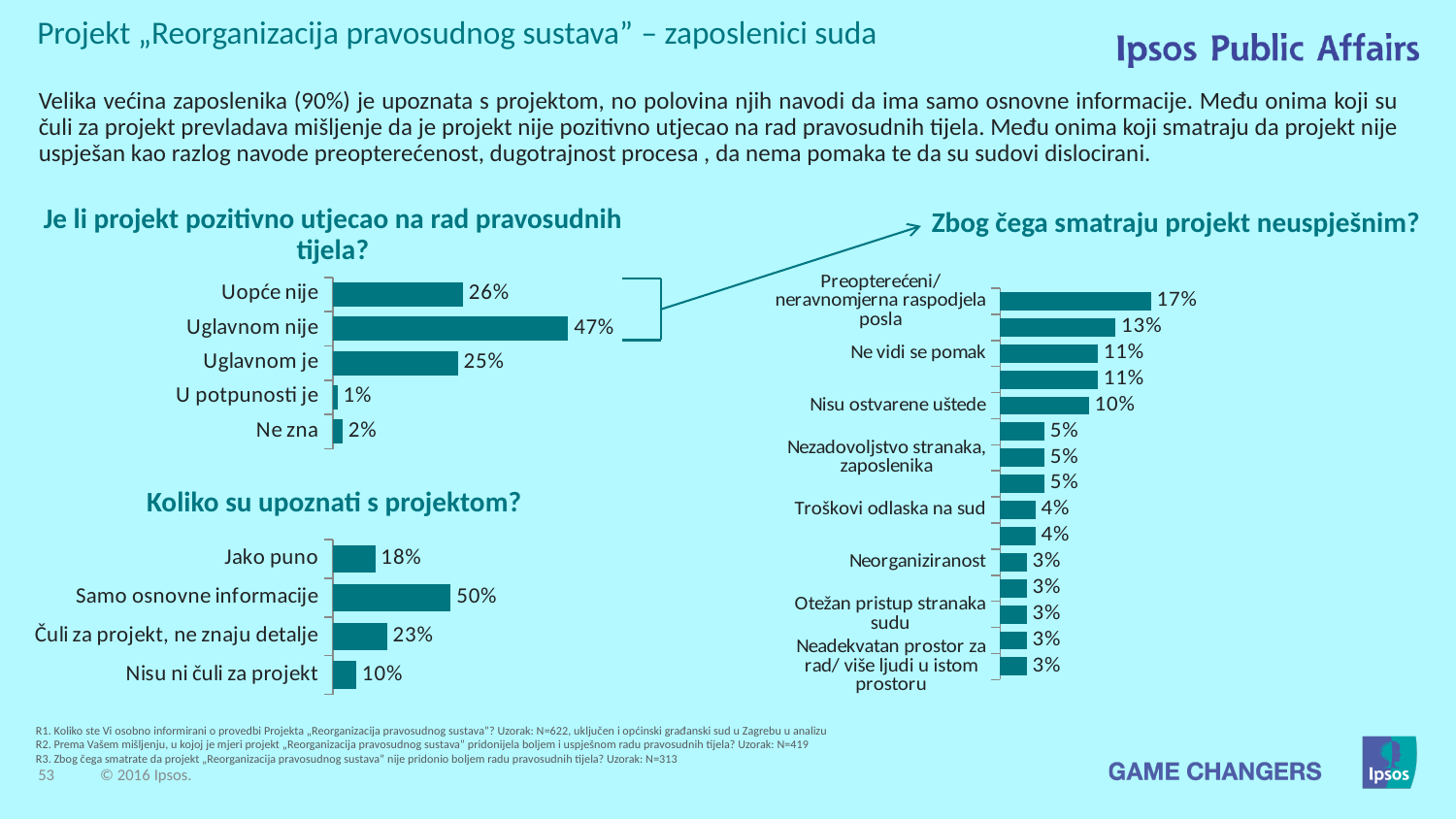
In the chart "Je li projekt pozitivno utjecao na rad pravosudnih tijela?", which category has the lowest value? U potpunosti je In the chart "Zbog čega smatraju projekt neuspješnim?", what is the value for "Preopterećeni/ neravnomjerna raspodjela posla"? 17% What type of chart is "Koliko su upoznati s projektom?"? Bar chart In the chart "Zbog čega smatraju projekt neuspješnim?", what is the value for "Nisu ostvarene uštede"? 10% In the chart "Zbog čega smatraju projekt neuspješnim?", which labelled reason has the highest value? Preopterećeni/ neravnomjerna raspodjela posla In the chart "Je li projekt pozitivno utjecao na rad pravosudnih tijela?", what is the difference between "Uopće nije" and "Uglavnom je"? 1 percentage point In the chart "Koliko su upoznati s projektom?", which category has the highest value? Samo osnovne informacije In the chart "Koliko su upoznati s projektom?", what is the difference between "Samo osnovne informacije" and "Nisu ni čuli za projekt"? 40 percentage points In the chart "Koliko su upoznati s projektom?", which is larger: "Jako puno" or "Čuli za projekt, ne znaju detalje"? Čuli za projekt, ne znaju detalje In the chart "Je li projekt pozitivno utjecao na rad pravosudnih tijela?", what is the value for "Uglavnom nije"? 47% In the chart "Je li projekt pozitivno utjecao na rad pravosudnih tijela?", how many categories are shown? 5 In the chart "Koliko su upoznati s projektom?", what is the value for "Samo osnovne informacije"? 50%